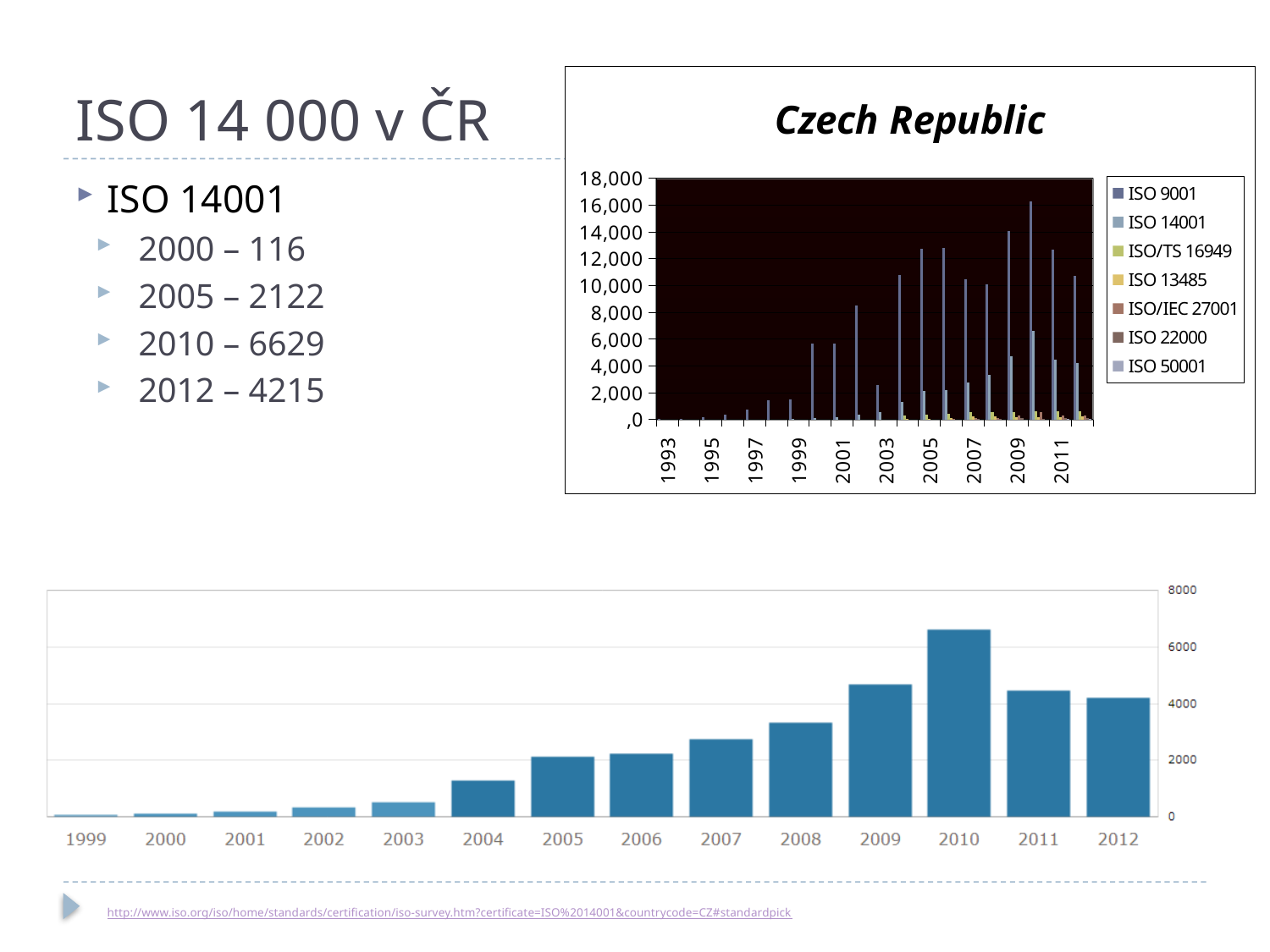
In the bottom chart, which year has the lowest bar? 1999 What kind of chart is the bottom chart showing ISO 14001 certificates from 1999 to 2012? bar chart How many years are shown on the x axis of the bottom chart? 14 In the bottom chart, which is larger, the value for 2011 or the value for 2012? 2011 How many series does the legend of the Czech Republic chart list? 7 In the bottom chart, is the value for 2008 greater or less than 4000? less In the Czech Republic chart, which series has the tallest bars? ISO 9001 In the bottom chart, is the value for 2004 greater or less than 2000? less In the bottom chart, which year has the highest bar? 2010 In the bottom chart, do the values rise or fall from 1999 to 2010? rise In the bottom chart, is the value for 2009 greater or less than 4000? greater